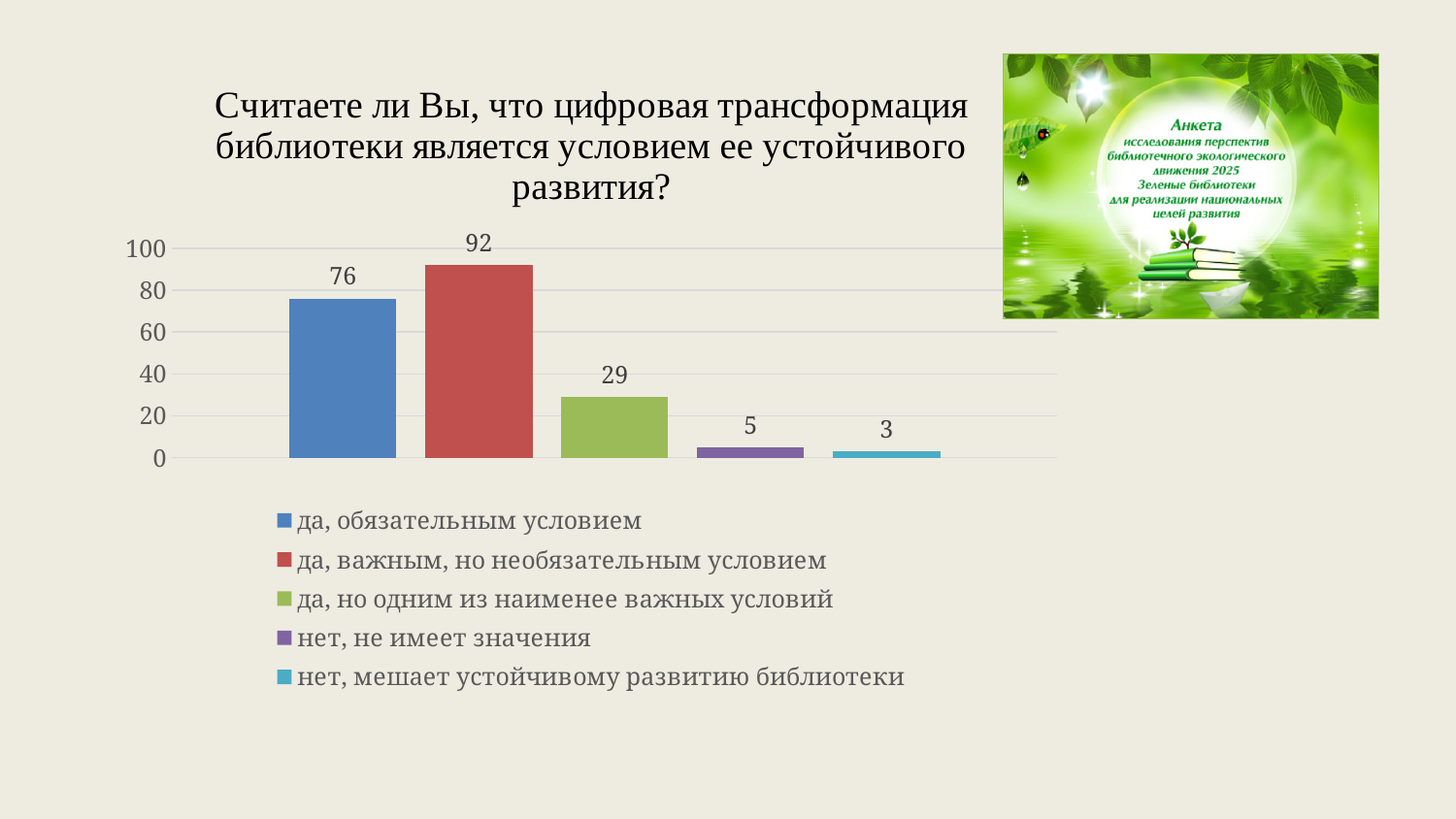
What is the value for "да, обязательным условием"? 76 Which category has the highest value? да, важным, но необязательным условием Which is larger: the value for "да, обязательным условием" or for "да, но одним из наименее важных условий"? да, обязательным условием Which category has the lowest value? нет, мешает устойчивому развитию библиотеки What is the value for "нет, мешает устойчивому развитию библиотеки"? 3 What kind of chart is shown on the slide? bar chart What is the value for "да, важным, но необязательным условием"? 92 What is the value for "нет, не имеет значения"? 5 How many categories are shown in the chart? 5 What is the value for "да, но одним из наименее важных условий"? 29 What is the difference between the values for "да, важным, но необязательным условием" and "да, обязательным условием"? 16 How many entries does the legend list? 5